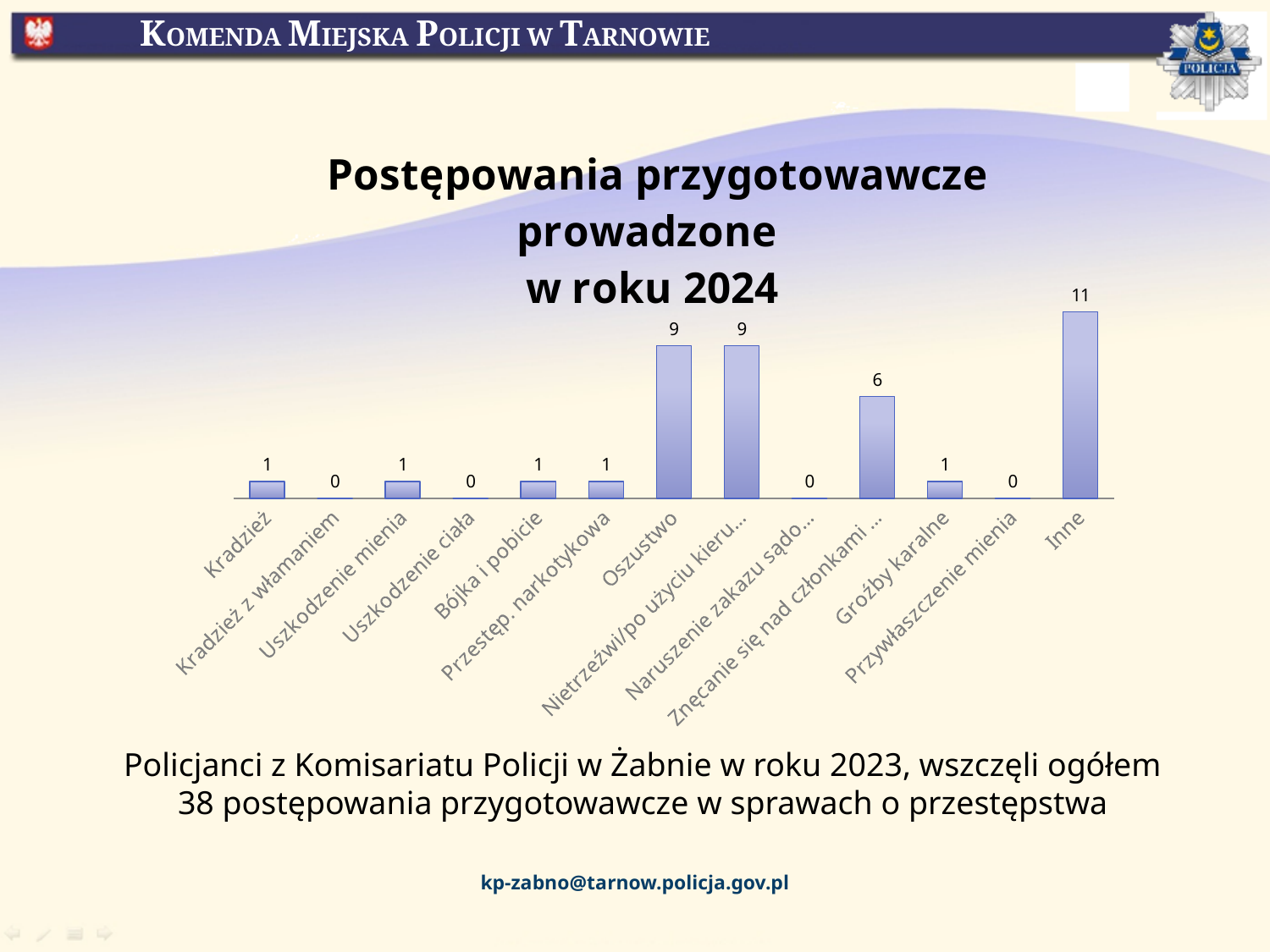
What is the difference between the values for Inne and Oszustwo? 2 What is the value for Groźby karalne? 1 What is the value for Oszustwo? 9 How many categories are shown on the x axis of the chart? 13 How many categories in the chart have a value of 0? 4 What is the value for Przywłaszczenie mienia? 0 Which category has the highest value in the chart? Inne What is the value for Kradzież? 1 What is the title of the chart? Postępowania przygotowawcze prowadzone w roku 2024 Which has a larger value, Oszustwo or Groźby karalne? Oszustwo What is the value for Inne? 11 What type of chart is shown on the slide? bar chart